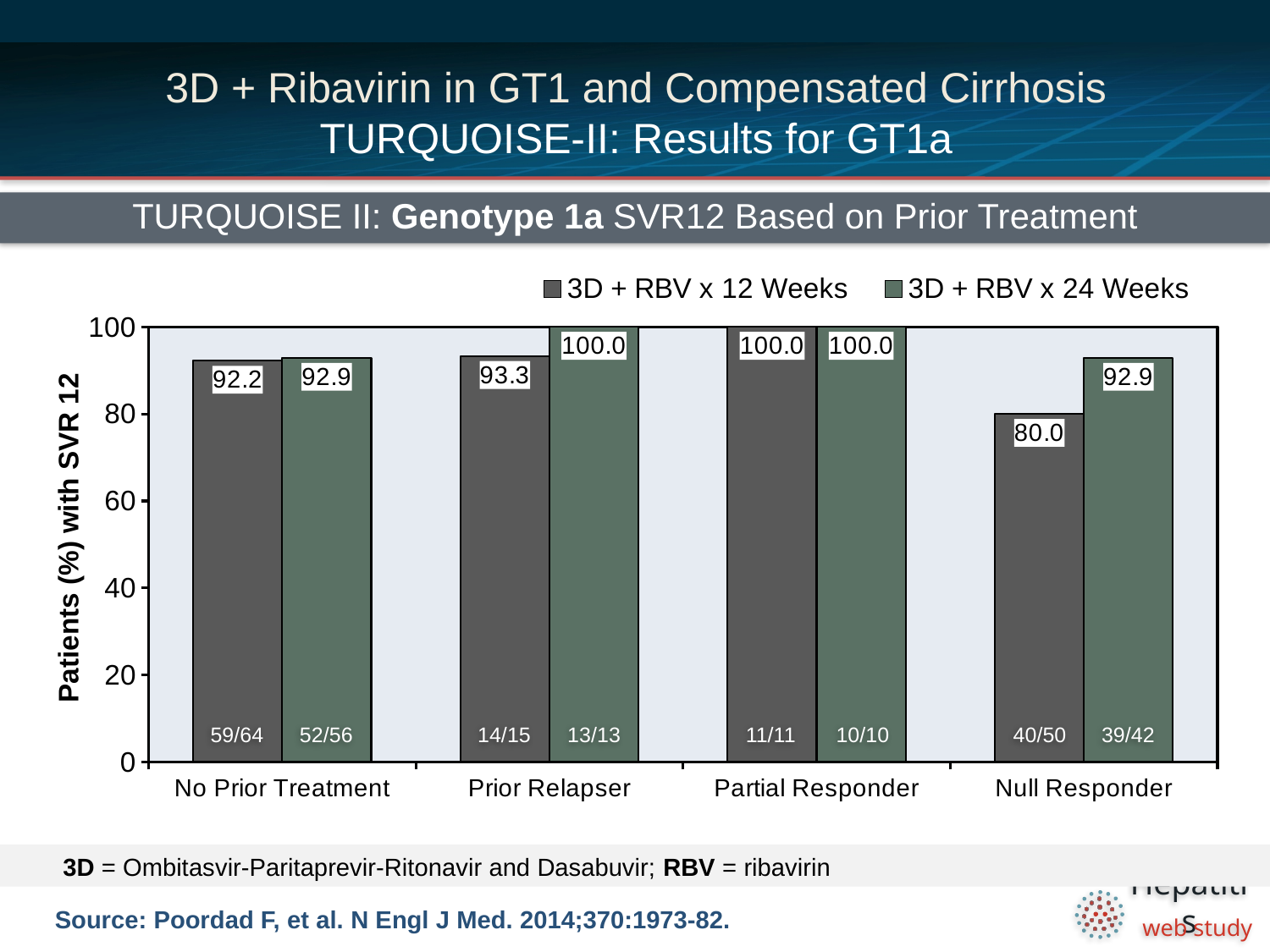
What is the SVR12 rate for the 3D + RBV x 12 Weeks series in the Prior Relapser group? 93.3 What is the difference between the 3D + RBV x 24 Weeks and 3D + RBV x 12 Weeks SVR12 rates in the Prior Relapser group? 6.7 In the Null Responder group, which series has the higher SVR12 rate, 3D + RBV x 12 Weeks or 3D + RBV x 24 Weeks? 3D + RBV x 24 Weeks What is the SVR12 rate for the 3D + RBV x 12 Weeks series in the No Prior Treatment group? 92.2 How many series does the legend list? 2 What kind of chart is shown on the slide? Bar chart What fraction of patients is printed on the 3D + RBV x 12 Weeks bar for the Null Responder group? 40/50 Which prior-treatment group has the lowest SVR12 rate for the 3D + RBV x 12 Weeks series? Null Responder What is the difference between the 3D + RBV x 24 Weeks and 3D + RBV x 12 Weeks SVR12 rates in the Null Responder group? 12.9 What is the label of the y axis? Patients (%) with SVR 12 What is the SVR12 rate for the 3D + RBV x 24 Weeks series in the Null Responder group? 92.9 How many prior-treatment categories are shown on the x axis? 4